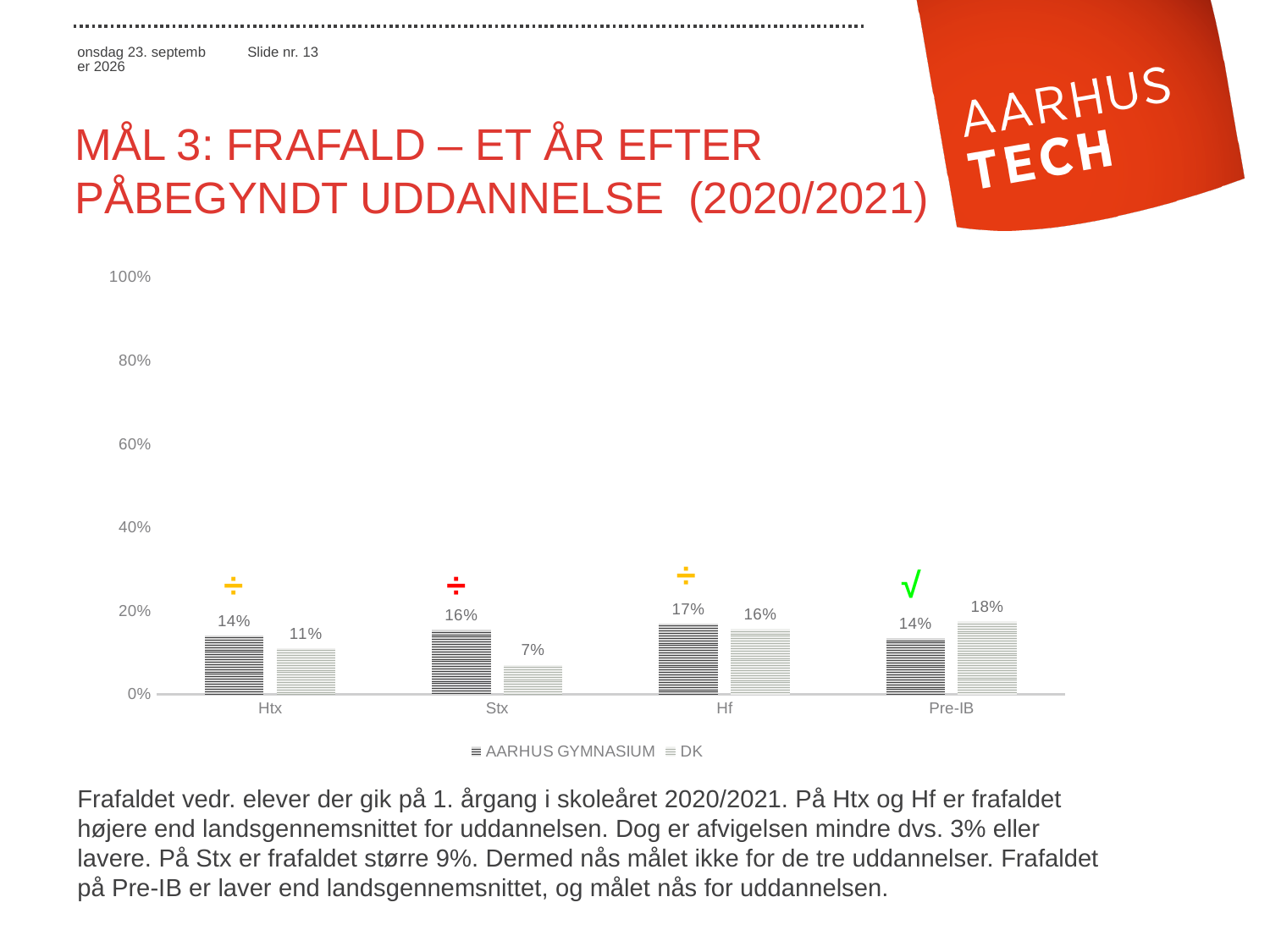
What is the AARHUS GYMNASIUM value for Hf? 17% For Pre-IB, which is larger: the AARHUS GYMNASIUM value or the DK value? DK Which category has the lowest DK value? Stx How many series does the legend list? 2 What is the DK value for Pre-IB? 18% What is the difference between the AARHUS GYMNASIUM and DK values for Stx? 9% What is the AARHUS GYMNASIUM value for Htx? 14% Which category has the highest AARHUS GYMNASIUM value? Hf How many categories are shown on the x axis? 4 What kind of chart is shown on the slide? Bar chart What is the DK value for Stx? 7% What is the difference between the DK and AARHUS GYMNASIUM values for Pre-IB? 4%